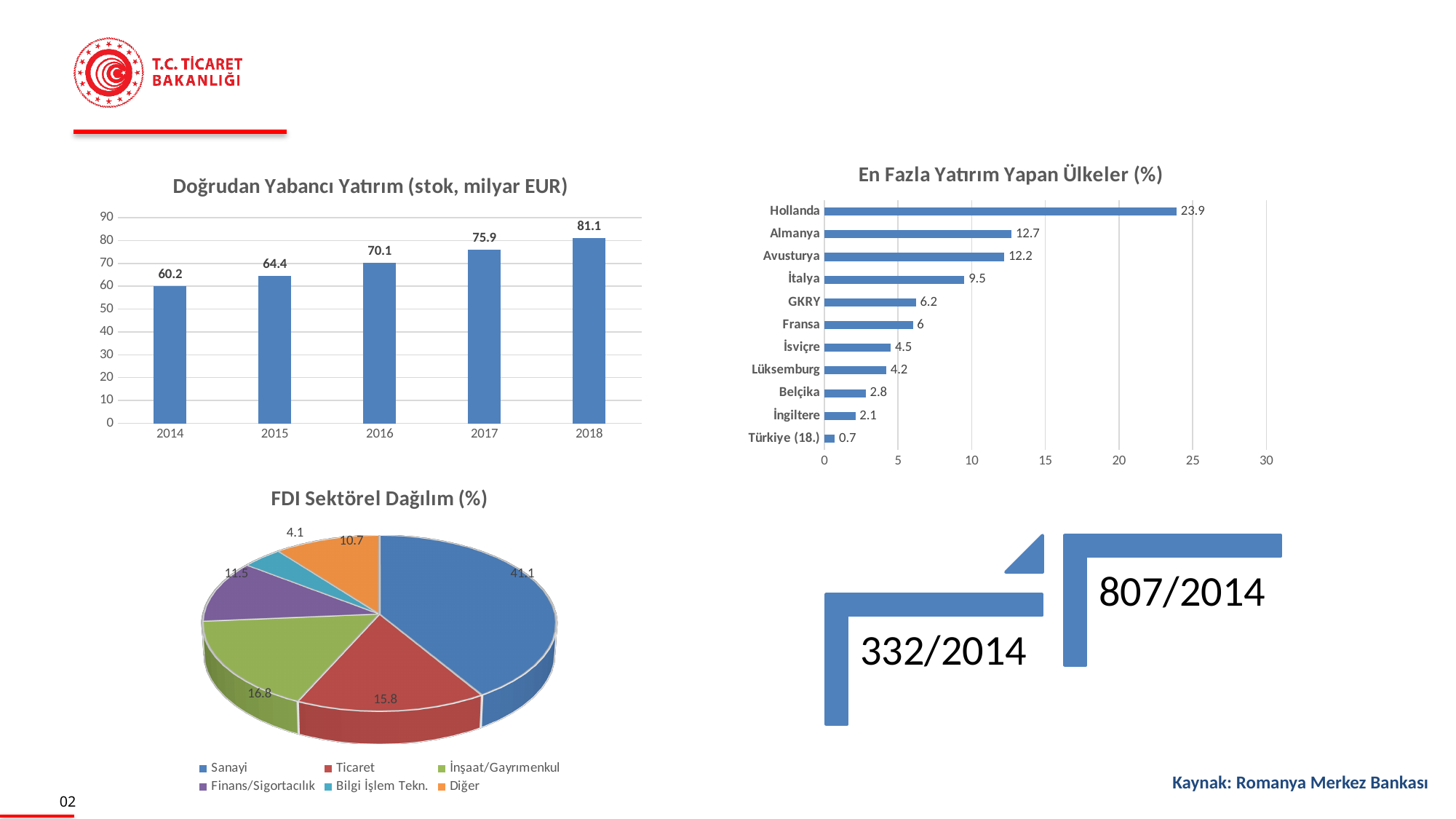
In the chart 'FDI Sektörel Dağılım (%)', how many sectors does the legend list? 6 In the chart 'En Fazla Yatırım Yapan Ülkeler (%)', how many countries are listed? 11 In the chart 'Doğrudan Yabancı Yatırım (stok, milyar EUR)', which year has the highest value? 2018 In the chart 'En Fazla Yatırım Yapan Ülkeler (%)', which is larger, the value for İtalya or the value for GKRY? İtalya In the chart 'Doğrudan Yabancı Yatırım (stok, milyar EUR)', do the values rise or fall from 2014 to 2018? rise In the chart 'En Fazla Yatırım Yapan Ülkeler (%)', what is the value for Almanya? 12.7 In the chart 'Doğrudan Yabancı Yatırım (stok, milyar EUR)', how many years are shown? 5 In the chart 'Doğrudan Yabancı Yatırım (stok, milyar EUR)', what is the difference between the 2018 and 2014 values? 20.9 In the chart 'En Fazla Yatırım Yapan Ülkeler (%)', which country has the lowest value? Türkiye (18.) In the chart 'FDI Sektörel Dağılım (%)', what is the value for Ticaret? 15.8 In the chart 'Doğrudan Yabancı Yatırım (stok, milyar EUR)', what is the value for 2016? 70.1 What kind of chart is 'En Fazla Yatırım Yapan Ülkeler (%)'? bar chart